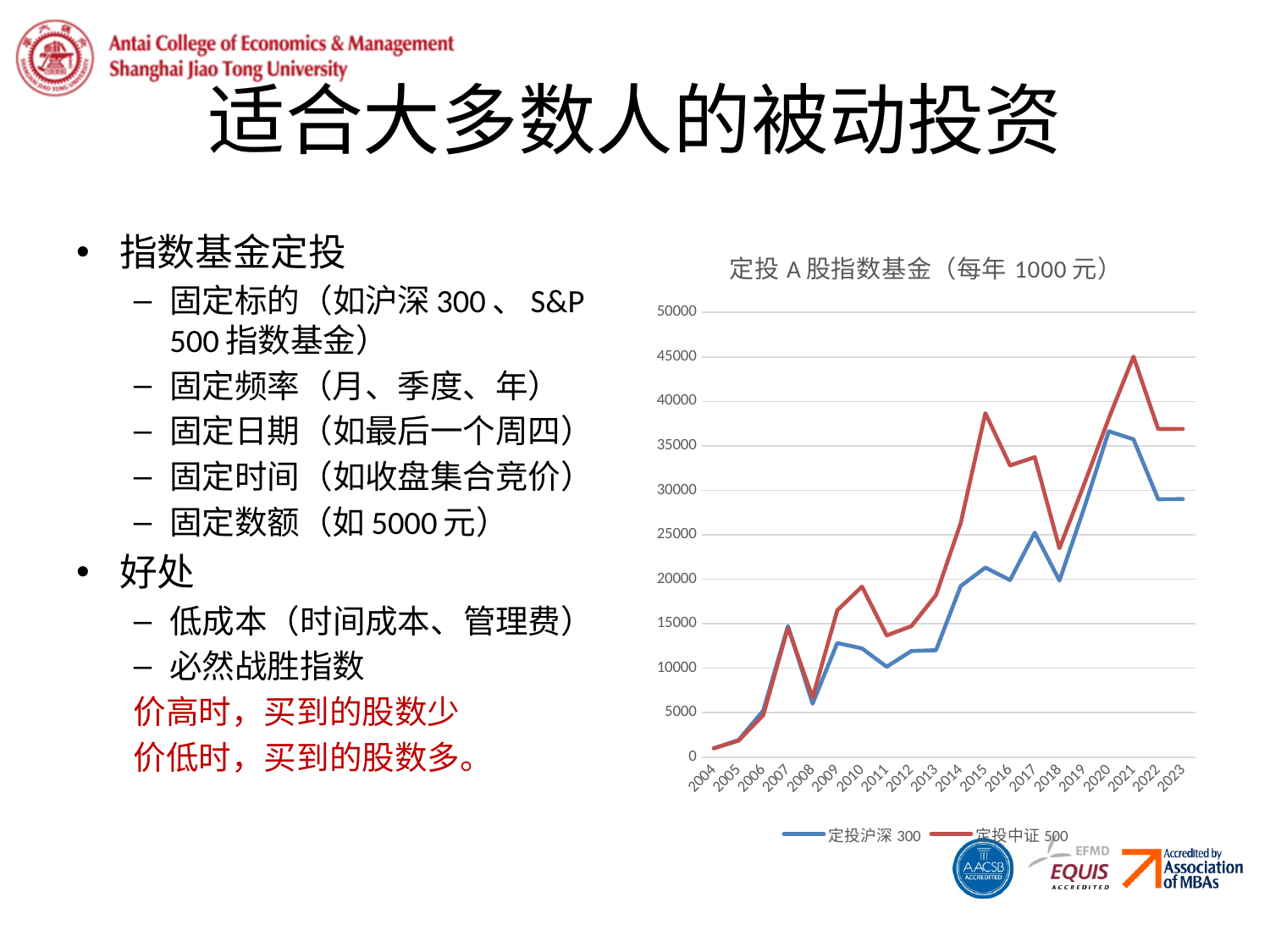
In which year is the 定投沪深 300 series at its lowest value? 2004 Overall, do the values of the 定投沪深 300 series rise or fall from 2004 to 2023? rise In 2023, which series has the larger value, 定投沪深 300 or 定投中证 500? 定投中证 500 What is the title of the chart? 定投 A 股指数基金（每年 1000 元） Is the value for 定投中证 500 in 2021 greater or less than 40000? greater Is the value for 定投中证 500 in 2015 greater or less than 35000? greater Is the value for 定投沪深 300 in 2008 greater or less than 10000? less What kind of chart is shown on the slide? line chart In which year does the 定投中证 500 series reach its highest value? 2021 How many years are plotted along the x axis of the chart? 20 How many series does the legend of the chart list? 2